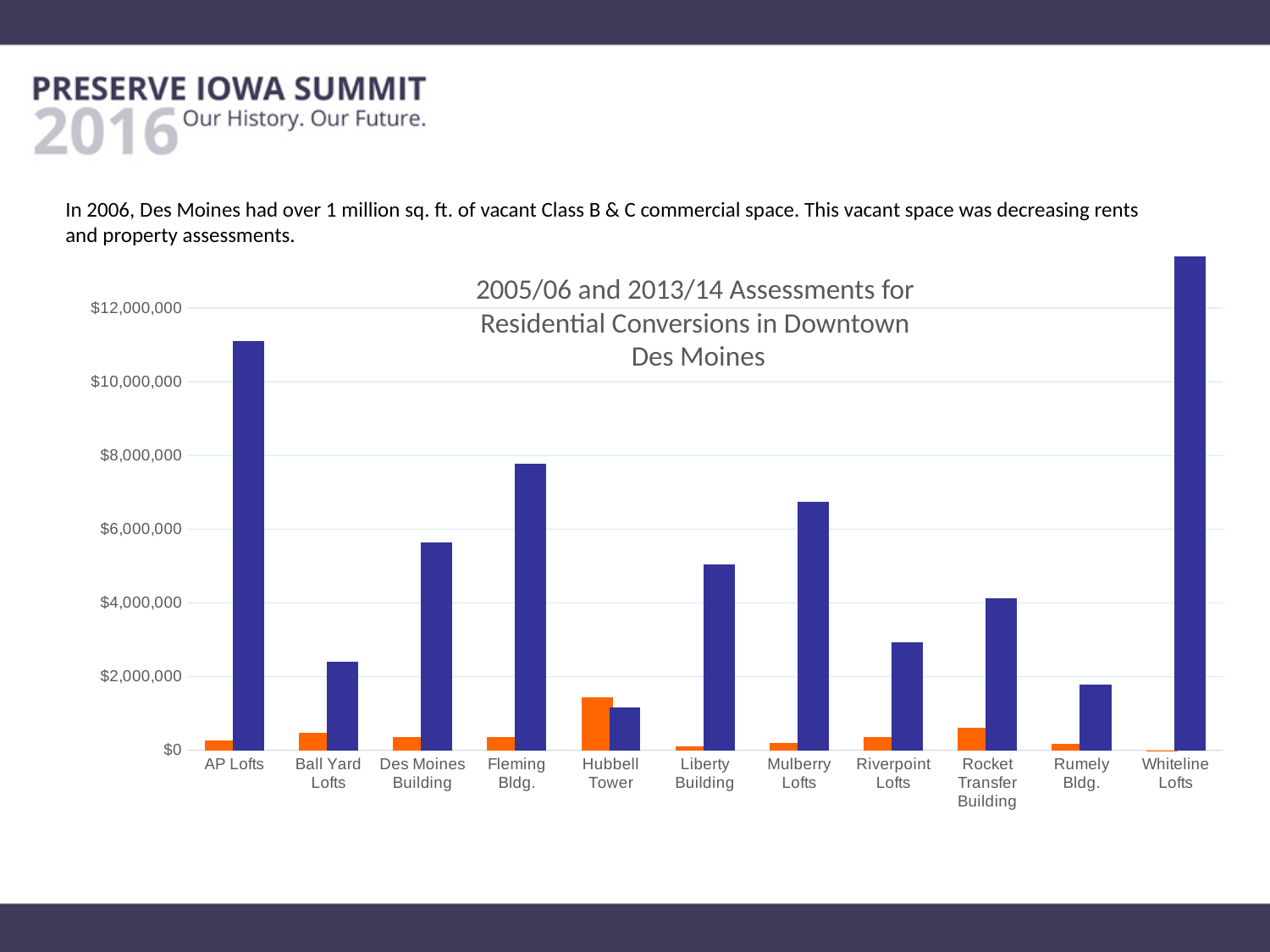
Is the blue bar for AP Lofts greater or less than $10,000,000? greater Which has the larger blue bar, Rocket Transfer Building or Riverpoint Lofts? Rocket Transfer Building What kind of chart is shown on the slide? Bar chart Which building has the shortest orange bar in the chart? Whiteline Lofts What is the title of the chart? 2005/06 and 2013/14 Assessments for Residential Conversions in Downtown Des Moines Which building has the tallest orange bar in the chart? Hubbell Tower Which building has the tallest blue bar in the chart? Whiteline Lofts Which building has the shortest blue bar in the chart? Hubbell Tower How many buildings (categories) are shown on the x axis of the chart? 11 Is the blue bar for Fleming Bldg. greater or less than $6,000,000? greater Which has the larger blue bar, Fleming Bldg. or Mulberry Lofts? Fleming Bldg. Is the orange bar for Hubbell Tower greater or less than $2,000,000? less